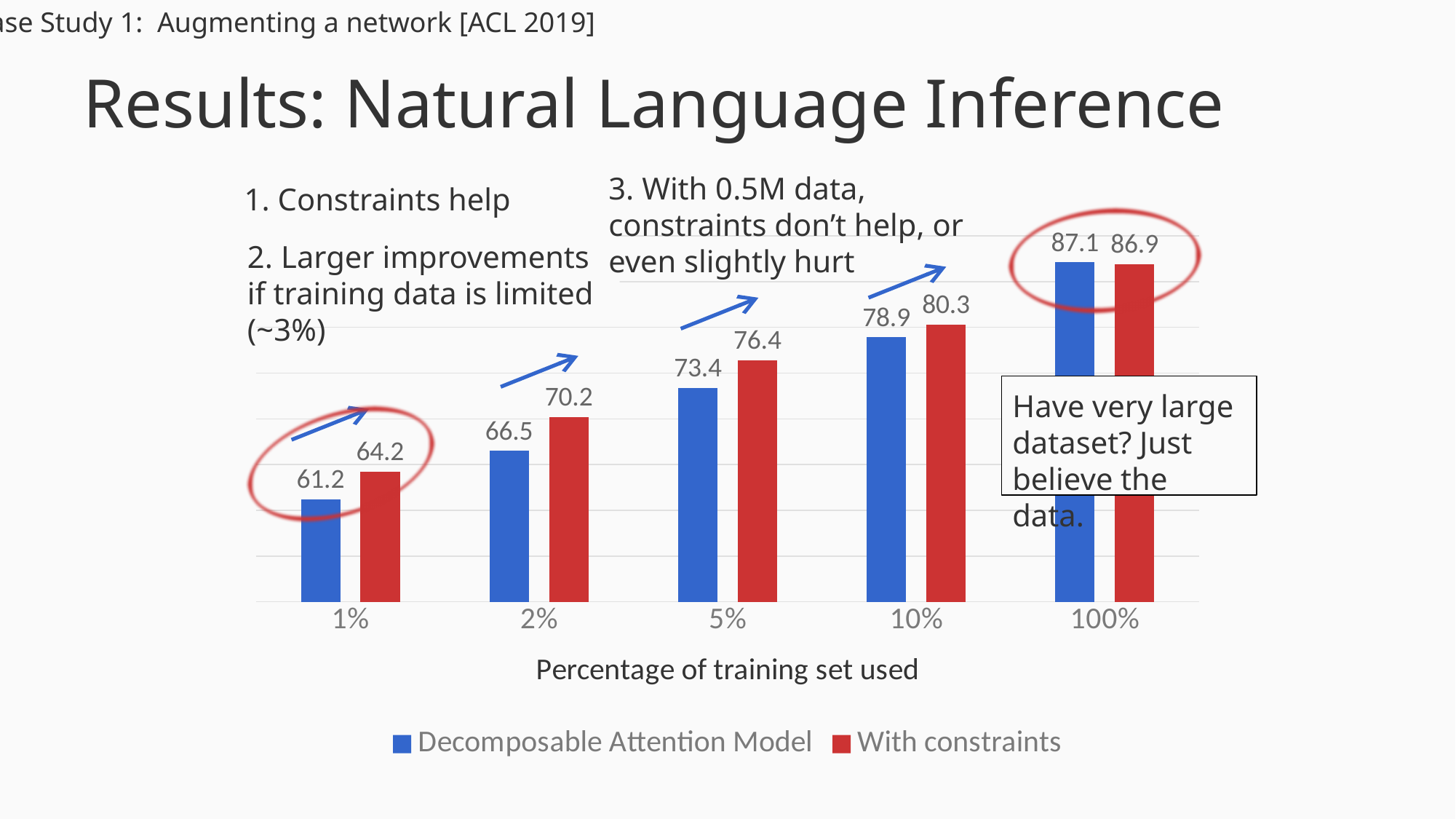
What is the value for With constraints at 5% of the training set? 76.4 How many percentage-of-training-set categories are shown on the x axis? 5 What is the value for With constraints at 100% of the training set? 86.9 At which percentage of the training set is the With constraints value lowest? 1% At which percentage of the training set is the Decomposable Attention Model value highest? 100% What is the difference between the With constraints value and the Decomposable Attention Model value at 2%? 3.7 At 100% of the training set, which series has the larger value: Decomposable Attention Model or With constraints? Decomposable Attention Model How many series does the legend list? 2 What kind of chart is shown on the slide? Bar chart Do the Decomposable Attention Model values rise or fall as the percentage of training set used increases? Rise What is the value for the Decomposable Attention Model at 10% of the training set? 78.9 What is the value for the Decomposable Attention Model at 1% of the training set? 61.2